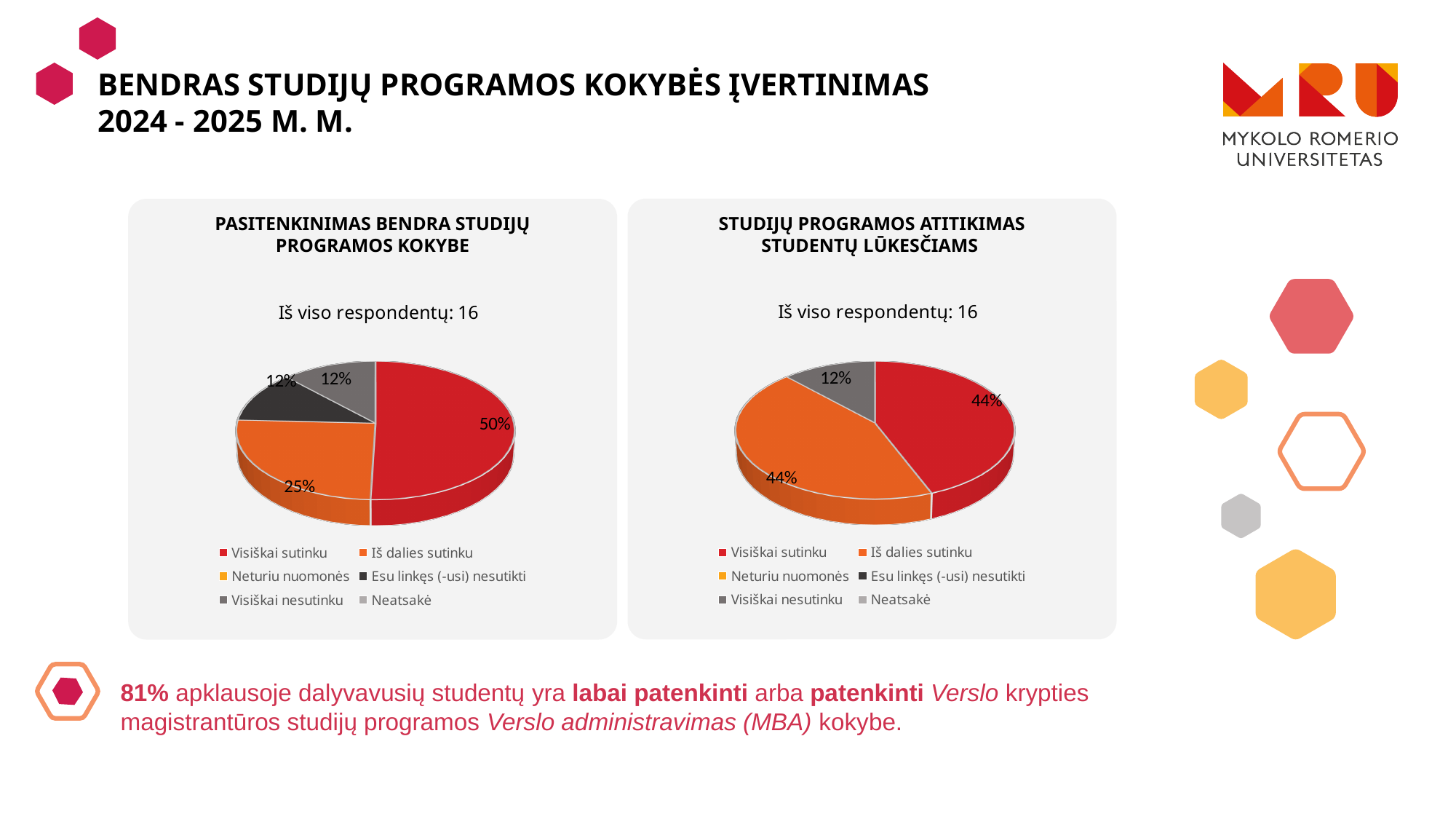
In the left chart 'PASITENKINIMAS BENDRA STUDIJŲ PROGRAMOS KOKYBE', what is the difference between the 'Visiškai sutinku' and 'Iš dalies sutinku' shares? 25% In the left chart 'PASITENKINIMAS BENDRA STUDIJŲ PROGRAMOS KOKYBE', which category has the largest slice? Visiškai sutinku In the right chart 'STUDIJŲ PROGRAMOS ATITIKIMAS STUDENTŲ LŪKESČIAMS', what share is labelled on the grey slice? 12% In the left chart 'PASITENKINIMAS BENDRA STUDIJŲ PROGRAMOS KOKYBE', what share is labelled for 'Visiškai sutinku'? 50% In the left chart 'PASITENKINIMAS BENDRA STUDIJŲ PROGRAMOS KOKYBE', what share is labelled for 'Iš dalies sutinku'? 25% In the right chart 'STUDIJŲ PROGRAMOS ATITIKIMAS STUDENTŲ LŪKESČIAMS', how many slices does the pie have? 3 In the right chart 'STUDIJŲ PROGRAMOS ATITIKIMAS STUDENTŲ LŪKESČIAMS', what share is labelled for 'Visiškai sutinku'? 44% How many entries does the legend of the left chart 'PASITENKINIMAS BENDRA STUDIJŲ PROGRAMOS KOKYBE' list? 6 In the right chart 'STUDIJŲ PROGRAMOS ATITIKIMAS STUDENTŲ LŪKESČIAMS', what share is labelled for 'Iš dalies sutinku'? 44% In the left chart 'PASITENKINIMAS BENDRA STUDIJŲ PROGRAMOS KOKYBE', how many slices does the pie have? 4 What type of chart is used in the left chart titled 'PASITENKINIMAS BENDRA STUDIJŲ PROGRAMOS KOKYBE'? Pie chart How many respondents are reported for the right chart 'STUDIJŲ PROGRAMOS ATITIKIMAS STUDENTŲ LŪKESČIAMS'? 16